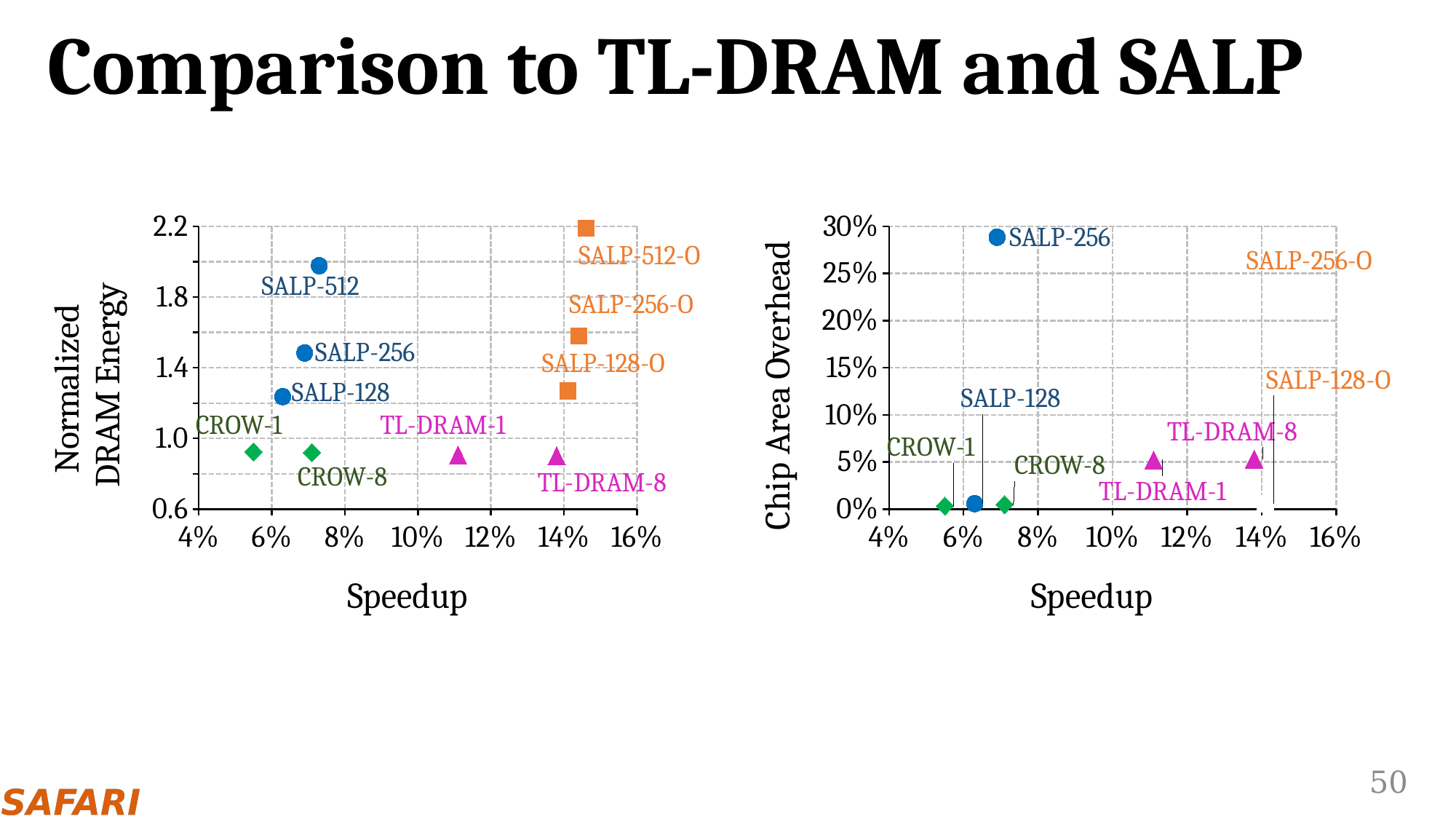
In the left chart (Normalized DRAM Energy), is the normalized DRAM energy for SALP-512 greater or less than 1.8? greater In the left chart (Normalized DRAM Energy), is the normalized DRAM energy for CROW-1 greater or less than 1.0? less What kind of chart is the left chart (Normalized DRAM Energy vs Speedup)? scatter chart In the left chart (Normalized DRAM Energy), which configuration has the highest normalized DRAM energy? SALP-512-O What is the x-axis label shared by both charts? Speedup In the right chart (Chip Area Overhead), is the speedup for TL-DRAM-8 greater or less than 12%? greater In the left chart (Normalized DRAM Energy), which has the higher normalized DRAM energy, SALP-256 or SALP-128? SALP-256 In the right chart (Chip Area Overhead), which has the higher chip area overhead, TL-DRAM-1 or CROW-8? TL-DRAM-1 In the left chart (Normalized DRAM Energy), how many data points are plotted? 10